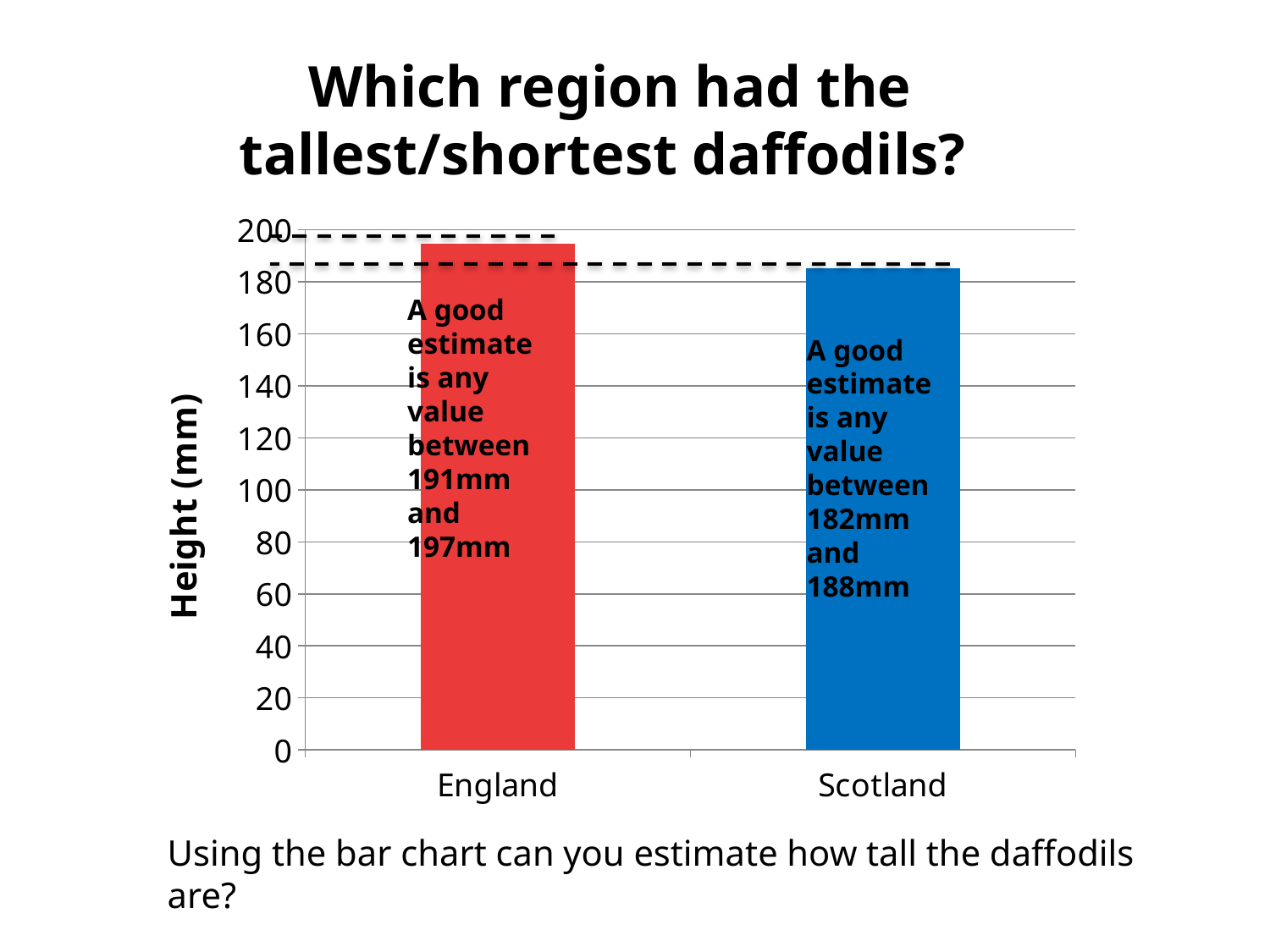
Which region has the shortest daffodils according to the bar chart? Scotland What is the label on the vertical axis of the chart? Height (mm) Which region has the tallest daffodils according to the bar chart? England Is the value for England greater or less than 180? greater How many regions are plotted on the bar chart? 2 Is the value for Scotland greater or less than 180? greater Is the value for England greater or less than 200? less Which bar is taller, England or Scotland? England What colour is the bar for Scotland? blue What kind of chart is shown on the slide? bar chart